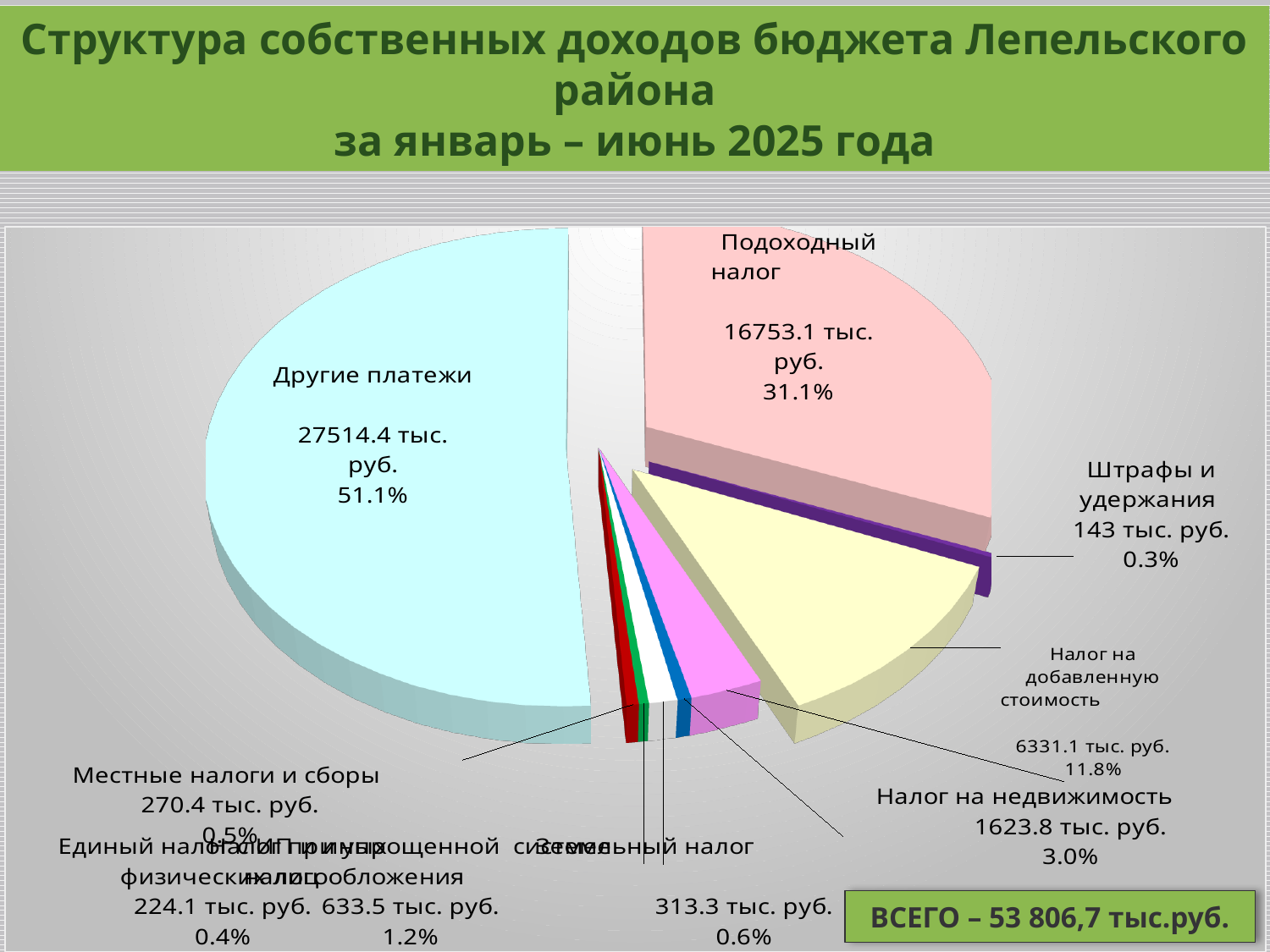
What total (ВСЕГО) is shown on the slide? 53 806,7 тыс.руб. What is the value shown for Земельный налог? 313.3 тыс. руб. What percentage of the pie is Налог на добавленную стоимость? 11.8% Which category has the largest slice of the pie? Другие платежи What is the value shown for Штрафы и удержания? 143 тыс. руб. What share of the pie does Другие платежи represent? 51.1% What share of the pie does Местные налоги и сборы represent? 0.5% What kind of chart is shown on the slide? pie chart Which is larger: Налог на добавленную стоимость or Налог на недвижимость? Налог на добавленную стоимость What is the value shown for Подоходный налог? 16753.1 тыс. руб. Which category has the smallest share of the pie? Штрафы и удержания What is the difference between the values for Подоходный налог and Налог на добавленную стоимость? 10422.0 тыс. руб.